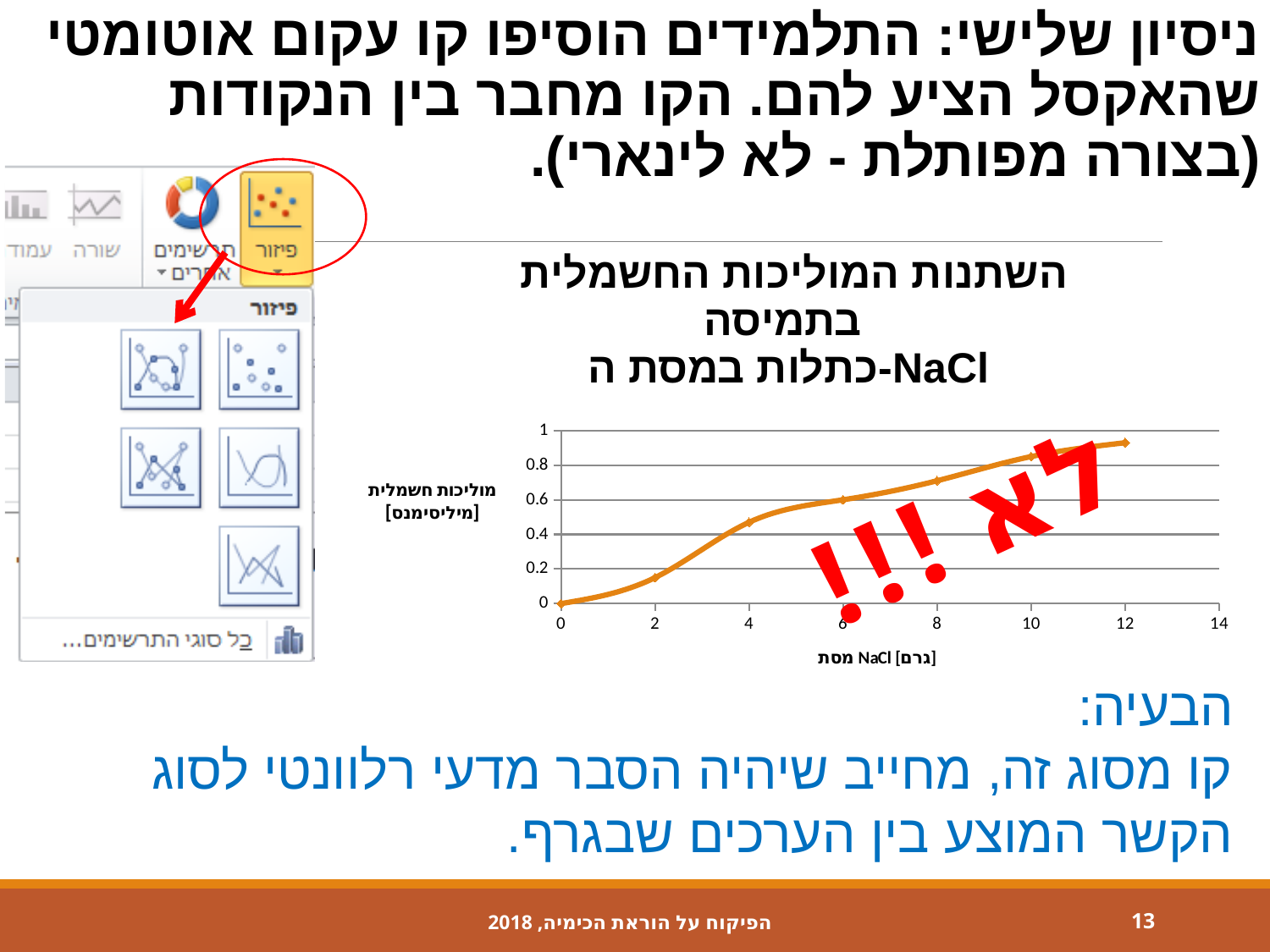
What is the label of the x axis of the chart? מסת NaCl [גרם] Which is larger, the conductivity at NaCl mass 4 or at NaCl mass 10? NaCl mass 10 At which NaCl mass is the conductivity lowest? 0 What kind of chart is shown on the slide? Scatter chart with a smoothed line Do the conductivity values rise or fall as the NaCl mass increases along the x axis? Rise Is the conductivity at NaCl mass 4 greater or less than 0.4? greater Is the conductivity at NaCl mass 12 greater or less than 0.8? greater What is the conductivity value at NaCl mass 0? 0 Is the conductivity at NaCl mass 8 greater or less than 0.6? greater At which NaCl mass is the conductivity highest? 12 How many data points are plotted on the chart? 7